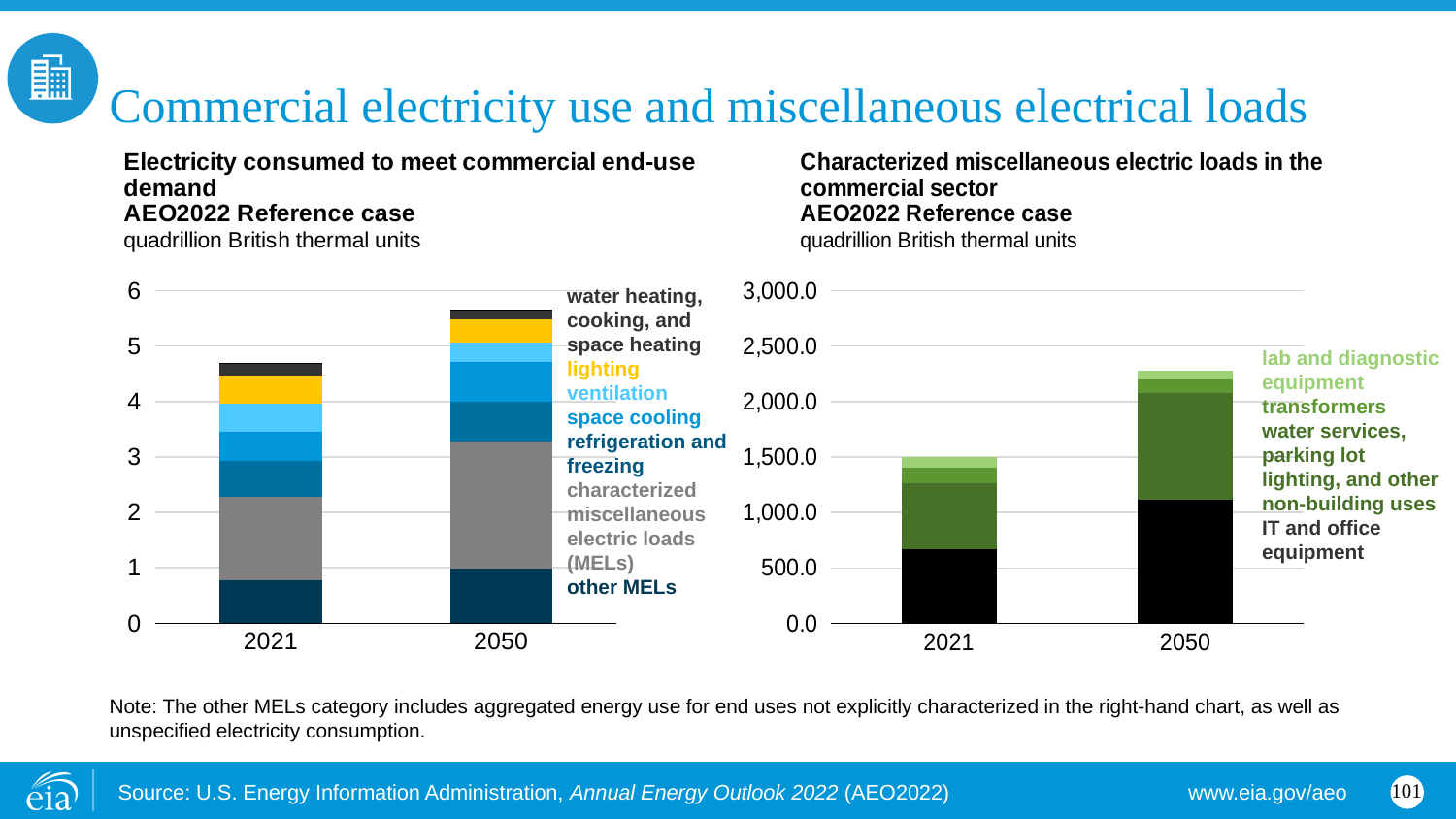
What type of chart is the right-hand chart, 'Characterized miscellaneous electric loads in the commercial sector'? stacked bar chart In the right-hand chart, 'Characterized miscellaneous electric loads in the commercial sector', how many series does the legend list? 4 What type of chart is the left-hand chart, 'Electricity consumed to meet commercial end-use demand'? stacked bar chart What unit is used on the y axis of the left-hand chart, 'Electricity consumed to meet commercial end-use demand'? quadrillion British thermal units In the left-hand chart, 'Electricity consumed to meet commercial end-use demand', how many series does the legend list? 7 In the right-hand chart, 'Characterized miscellaneous electric loads in the commercial sector', do the total loads rise or fall from 2021 to 2050? rise In the right-hand chart, 'Characterized miscellaneous electric loads in the commercial sector', is the total for 2050 greater or less than 2,000.0? greater In the left-hand chart, 'Electricity consumed to meet commercial end-use demand', how many years are shown on the x axis? 2 In the left-hand chart, 'Electricity consumed to meet commercial end-use demand', is the total for 2021 greater or less than 4? greater In the left-hand chart, 'Electricity consumed to meet commercial end-use demand', is the total for 2050 greater or less than 6? less In the left-hand chart, 'Electricity consumed to meet commercial end-use demand', which year has the taller total bar, 2021 or 2050? 2050